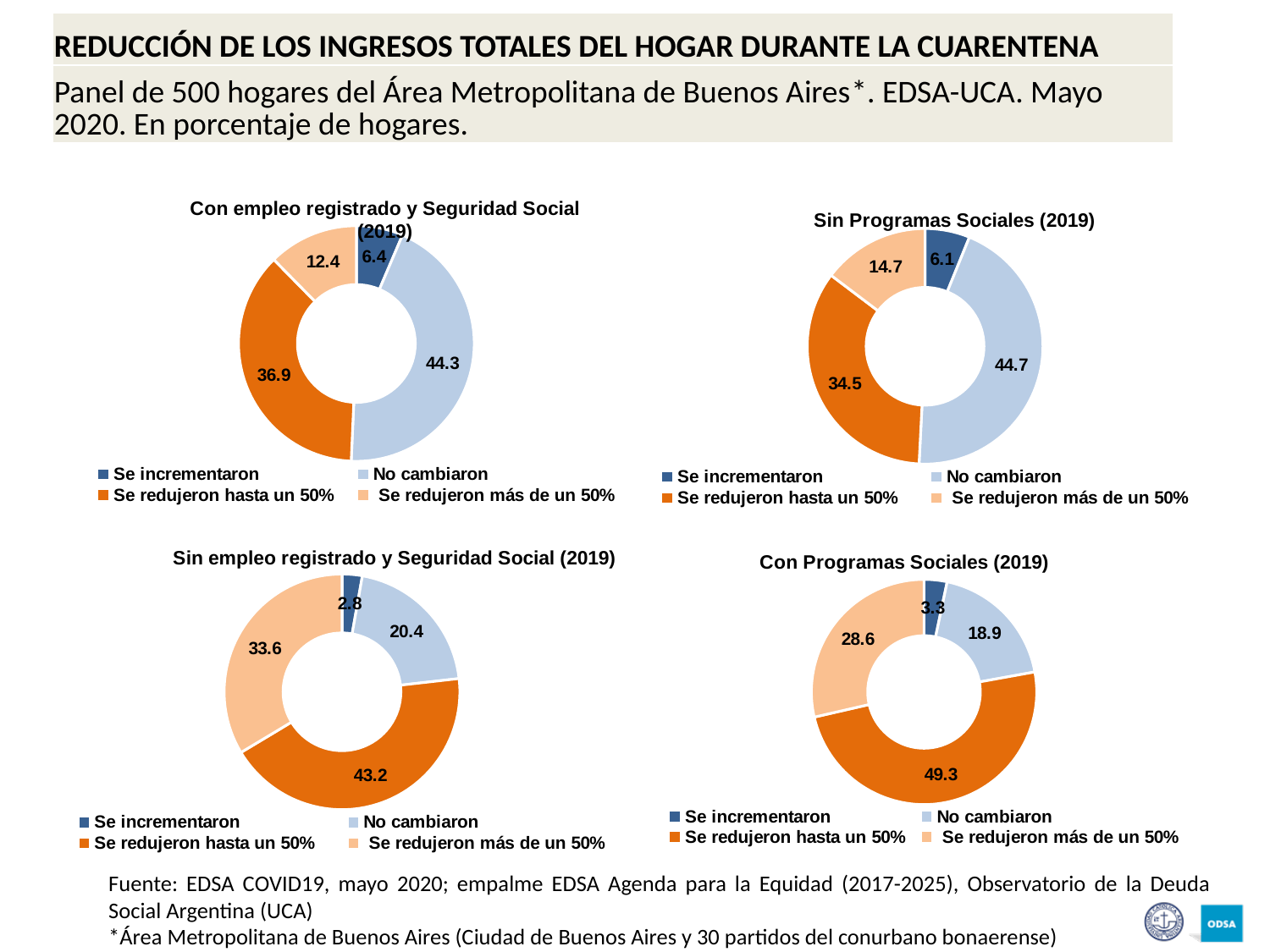
How many charts are on the slide? 4 In the 'Sin empleo registrado y Seguridad Social (2019)' chart, what is the value for 'Se incrementaron'? 2.8 In the 'Con empleo registrado y Seguridad Social (2019)' chart, what is the value for 'No cambiaron'? 44.3 How many categories does the 'Con Programas Sociales (2019)' chart show? 4 In the 'Sin Programas Sociales (2019)' chart, which category has the smallest share? Se incrementaron In the 'Con empleo registrado y Seguridad Social (2019)' chart, which is larger: 'No cambiaron' or 'Se redujeron hasta un 50%'? No cambiaron In the 'Sin Programas Sociales (2019)' chart, what is the value for 'Se redujeron hasta un 50%'? 34.5 In the 'Con Programas Sociales (2019)' chart, what is the value for 'Se redujeron más de un 50%'? 28.6 In the 'Sin empleo registrado y Seguridad Social (2019)' chart, what is the difference between 'Se redujeron hasta un 50%' and 'Se redujeron más de un 50%'? 9.6 In the 'Sin empleo registrado y Seguridad Social (2019)' chart, what is the value for 'No cambiaron'? 20.4 In the 'Con Programas Sociales (2019)' chart, which category has the largest share? Se redujeron hasta un 50% What kind of chart is the 'Sin Programas Sociales (2019)' chart? doughnut chart